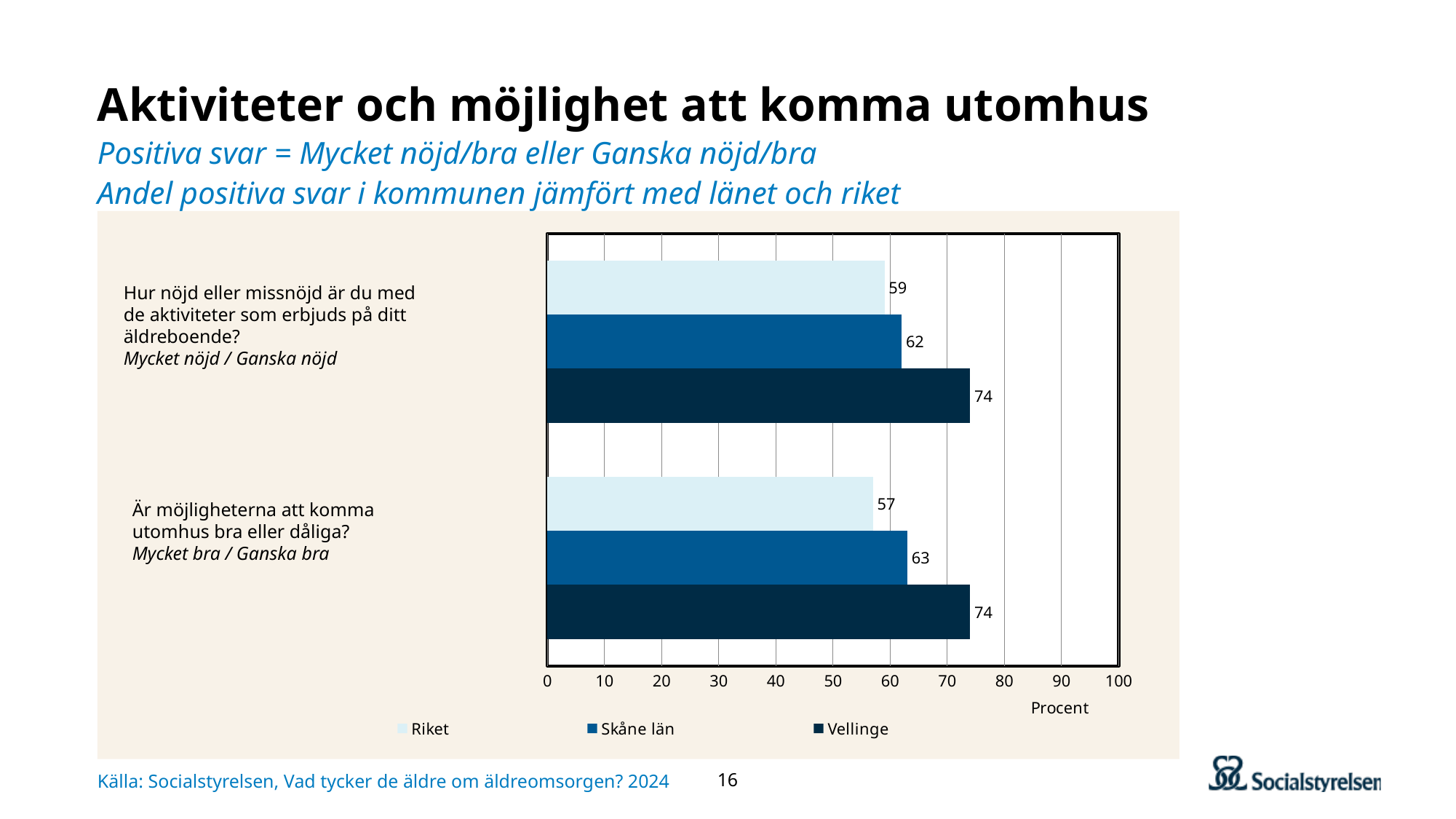
How many question categories are shown on the chart? 2 What is the difference between Vellinge and Riket on the question about opportunities to get outdoors? 17 How many series does the legend list? 3 What is the unit label shown on the x axis? Procent Which series has the highest value on the question about opportunities to get outdoors? Vellinge What is the value for Skåne län on the question about satisfaction with activities offered? 62 Which is larger: Skåne län on the activities question or Skåne län on the outdoors question? Skåne län on the outdoors question Which series has the lowest value on the question about satisfaction with activities offered? Riket What is the difference between Vellinge and Skåne län on the question about satisfaction with activities offered? 12 What is the value for Vellinge on the question about satisfaction with activities offered at the care home? 74 What kind of chart is shown on the slide? Bar chart What is the value for Riket on the question about opportunities to get outdoors? 57